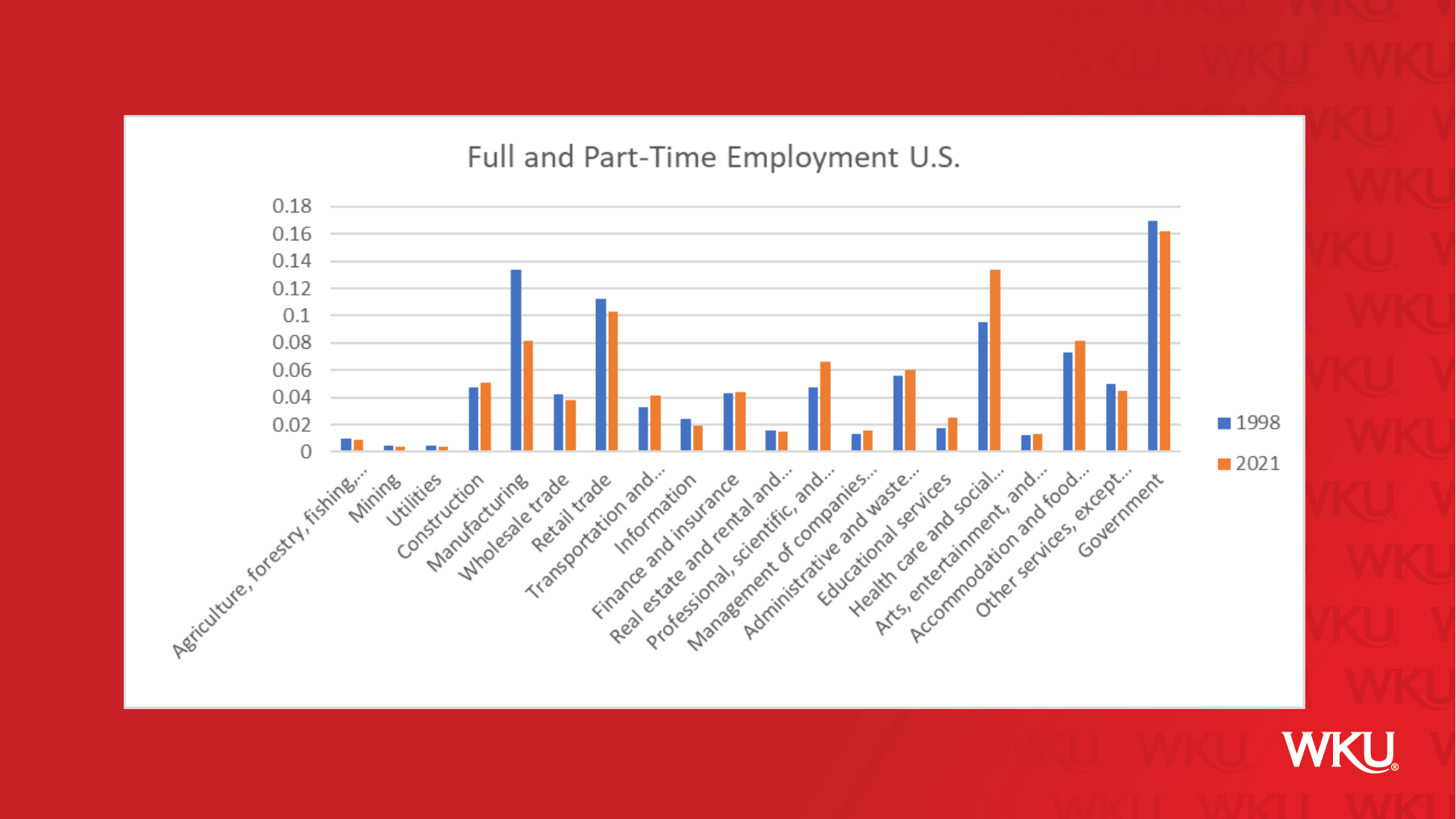
What are the two series named in the legend? 1998 and 2021 What kind of chart is shown on the slide? bar chart What is the title of the chart? Full and Part-Time Employment U.S. For Health care and social..., which series has the larger value, 1998 or 2021? 2021 For Manufacturing, which series has the larger value, 1998 or 2021? 1998 Is the 1998 value for Government greater or less than 0.16? greater Is the 1998 value for Manufacturing greater or less than 0.12? greater Which category has the highest value for 1998? Government How many industry categories are shown on the x axis? 20 How many series does the legend list? 2 Which category has the highest value for 2021? Government Is the 2021 value for Manufacturing greater or less than 0.1? less